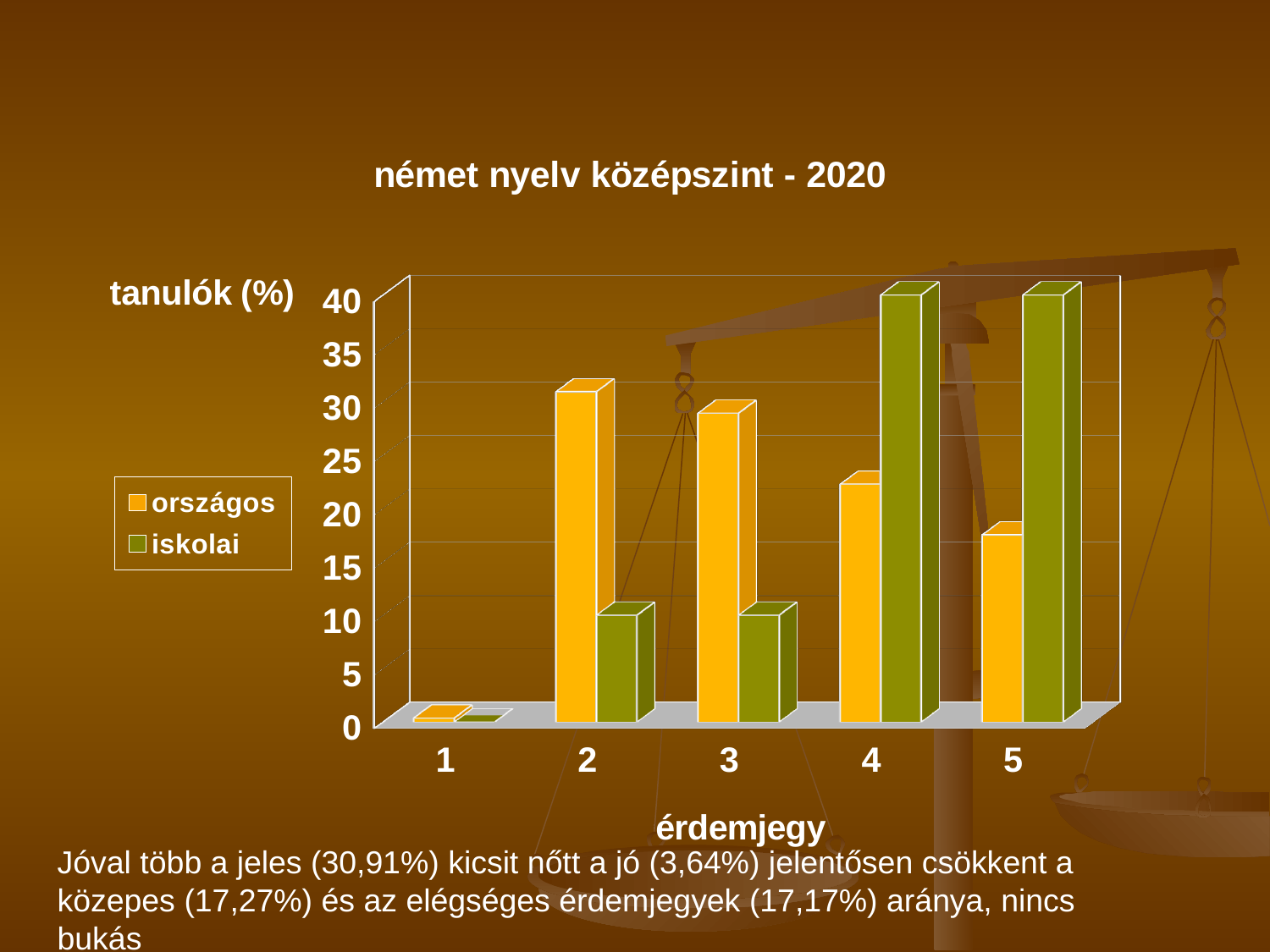
What are the two series named in the legend? országos, iskolai For érdemjegy 4, which series has the larger value, országos or iskolai? iskolai Is the országos value for érdemjegy 5 greater or less than 20? less Is the iskolai value for érdemjegy 4 greater or less than 35? greater Do the iskolai values rise or fall as érdemjegy goes from 1 to 5? rise For érdemjegy 2, which series has the larger value, országos or iskolai? országos What is the title of the chart? német nyelv középszint - 2020 Which érdemjegy category has the lowest országos value? 1 How many érdemjegy categories are shown on the x axis? 5 How many series does the legend list? 2 Which érdemjegy category has the highest országos value? 2 What kind of chart is shown on the slide? bar chart